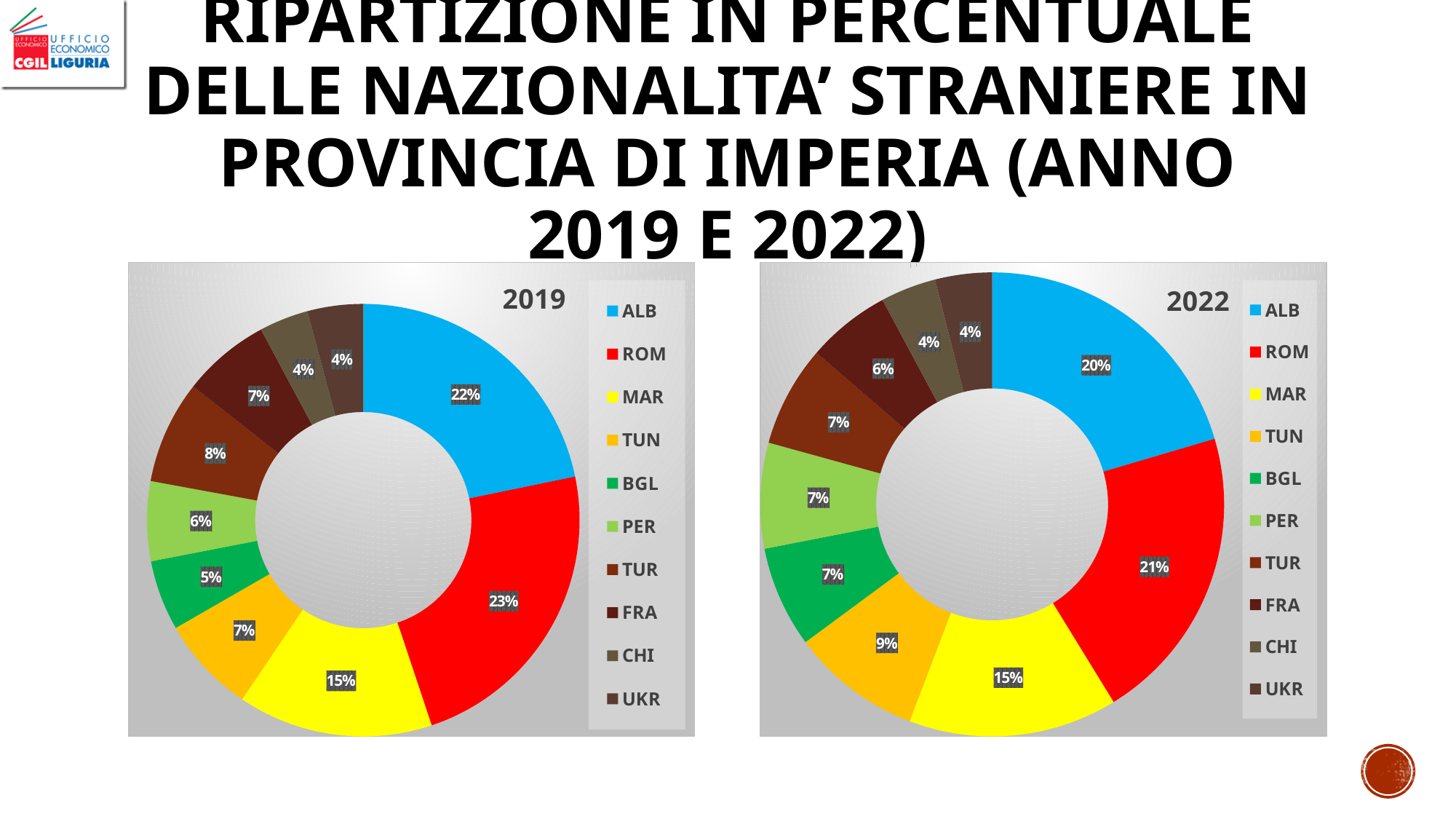
What kind of chart is the 2019 chart? Doughnut (pie) chart In the 2022 chart, what percentage is shown for TUN? 9% In the 2022 chart, what colour is the MAR slice? Yellow In the 2019 chart, what is the difference between the ALB share and the MAR share? 7% In the 2019 chart, which is larger, the share for TUR or the share for PER? TUR In the 2019 chart, what percentage is shown for ROM? 23% In the 2022 chart, what percentage is shown for ALB? 20% In the 2022 chart, which nationality has the largest share? ROM How many nationalities does the legend of the 2022 chart list? 10 In the 2019 chart, what percentage is shown for BGL? 5% In the 2022 chart, what is the difference between the ROM share and the ALB share? 1% In the 2019 chart, which nationality has the largest share? ROM